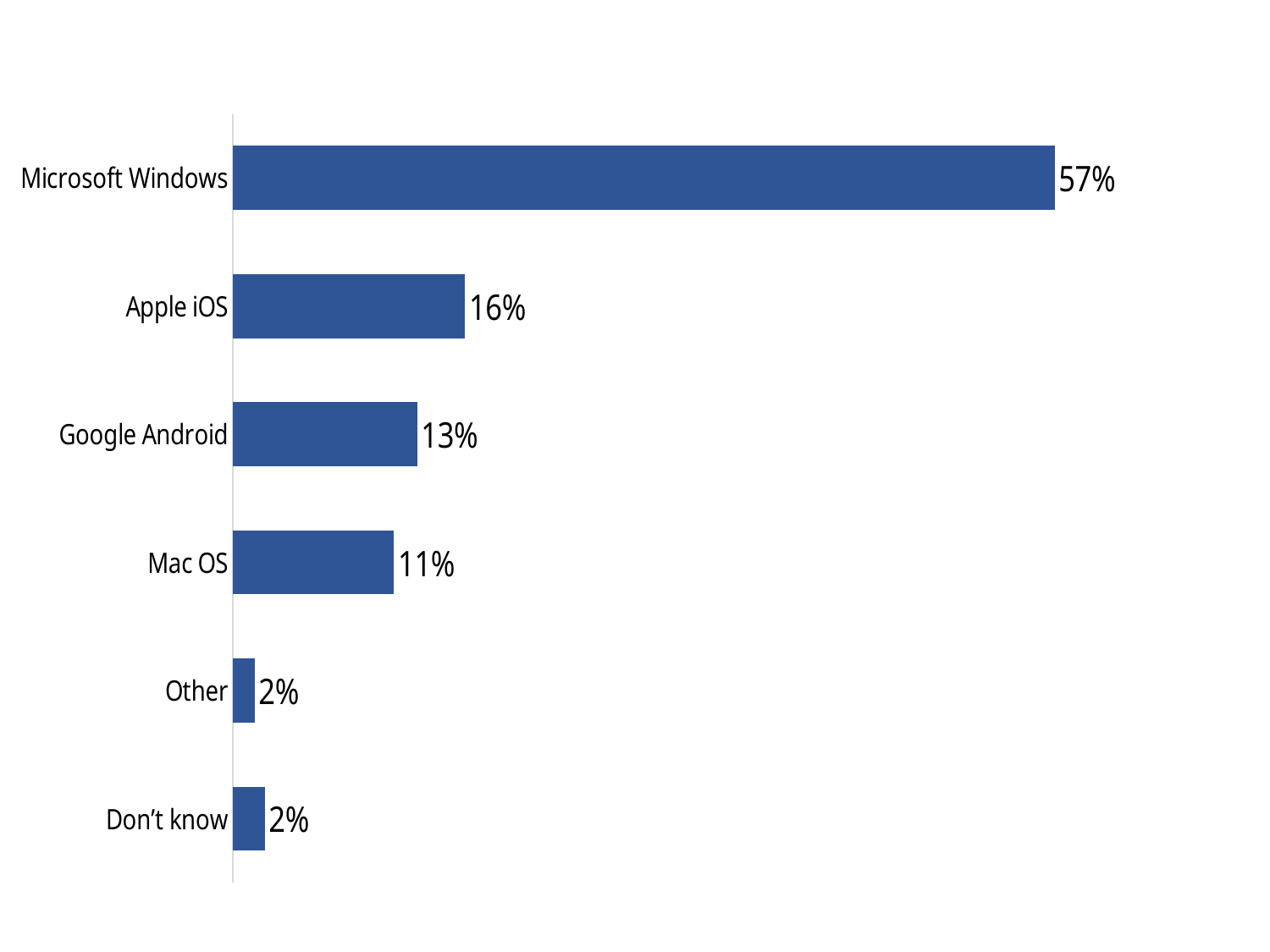
What kind of chart is this? Bar chart What is the value for Mac OS? 11% Which category has the highest value? Microsoft Windows How many categories are shown in the chart? 6 Which is larger, the value for Apple iOS or the value for Google Android? Apple iOS What is the difference between the values for Google Android and Mac OS? 2% What is the value for Don't know? 2% What is the value for Microsoft Windows? 57% What is the difference between the values for Microsoft Windows and Apple iOS? 41% What is the value for Google Android? 13% What is the value for Apple iOS? 16% What colour are the bars in the chart? Blue